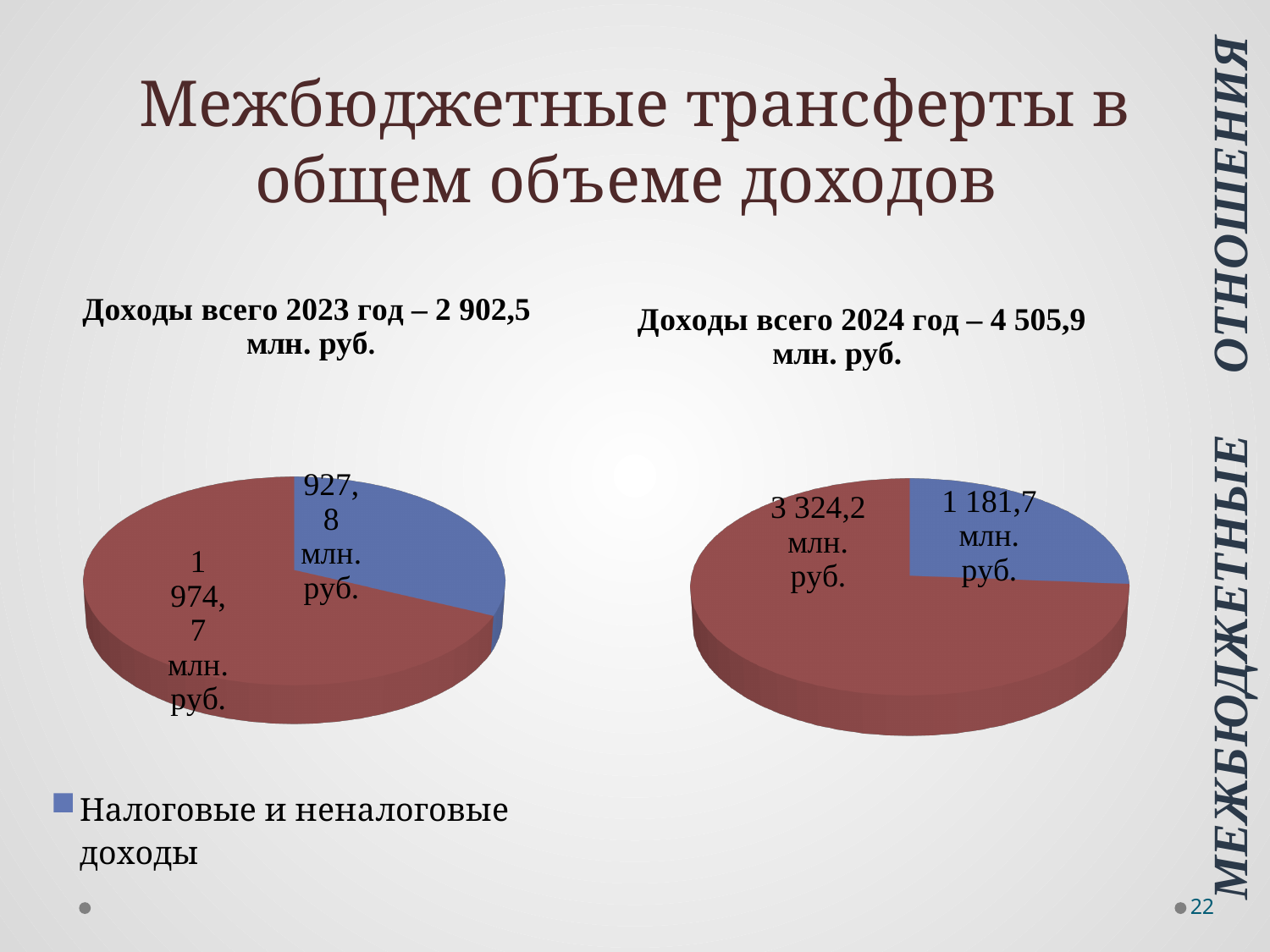
What kind of chart is used on this slide for the 2023 and 2024 income data? Pie chart What total income is stated in the title of the 2024 pie chart? 4 505,9 млн. руб. In the 2024 pie chart, what is the difference between the red slice and the Налоговые и неналоговые доходы slice? 2 142,5 млн. руб. In the 2023 pie chart (Доходы всего 2023 год), what is the value of the Налоговые и неналоговые доходы slice? 927,8 млн. руб. How many slices does each pie chart on the slide have? 2 In the 2023 pie chart (Доходы всего 2023 год), what is the value of the red slice? 1 974,7 млн. руб. In the 2024 pie chart (Доходы всего 2024 год), what is the value of the red slice? 3 324,2 млн. руб. By how much did Налоговые и неналоговые доходы increase from the 2023 pie chart to the 2024 pie chart? 253,9 млн. руб. In the 2023 pie chart, which slice is larger: the blue slice or the red slice? The red slice In the 2024 pie chart, which slice is the smallest? Налоговые и неналоговые доходы (1 181,7 млн. руб.) In the 2023 pie chart, what is the difference between the red slice and the Налоговые и неналоговые доходы slice? 1 046,9 млн. руб. In the 2024 pie chart (Доходы всего 2024 год), what is the value of the Налоговые и неналоговые доходы slice? 1 181,7 млн. руб.